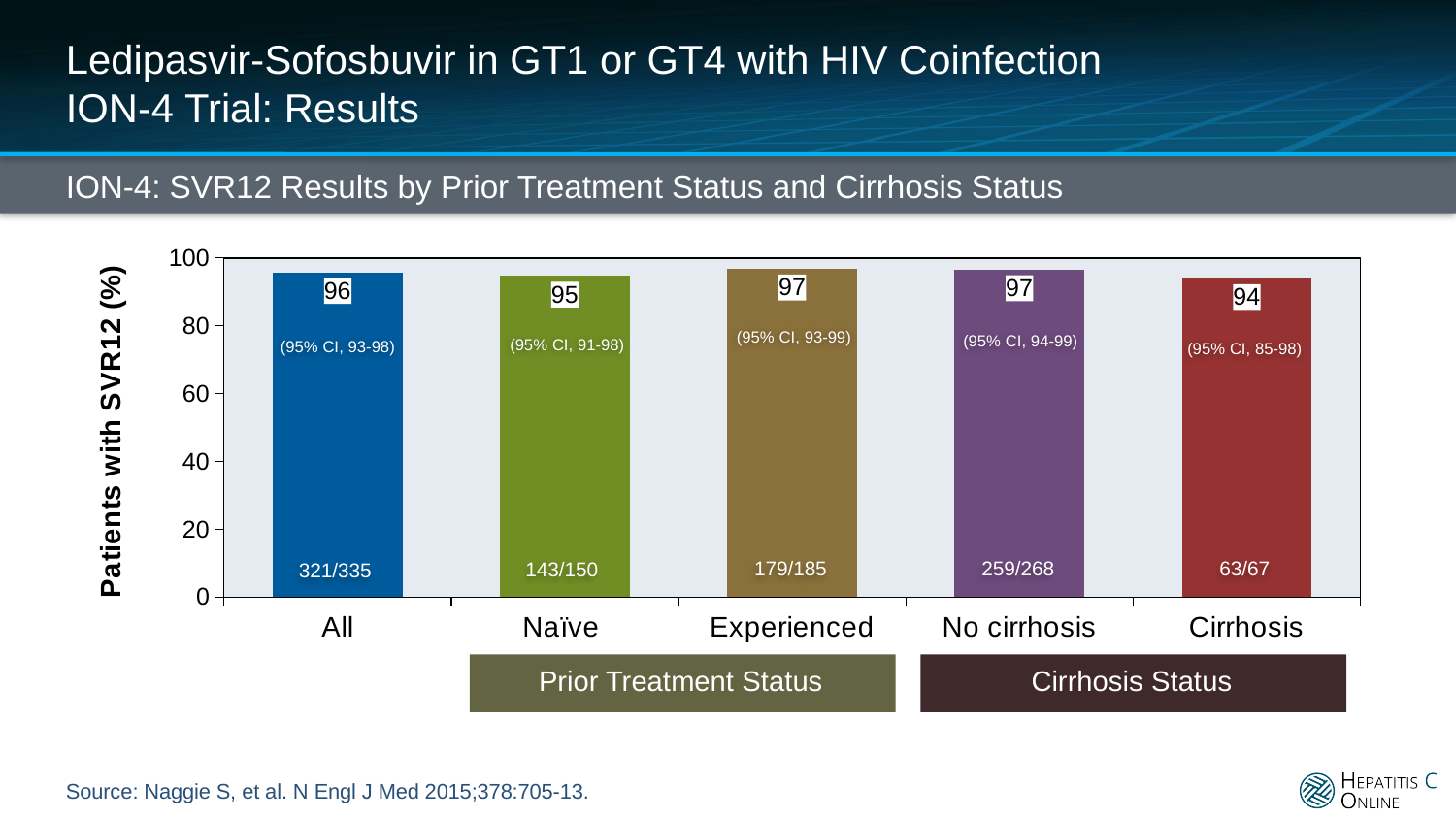
What is the y-axis label of the chart? Patients with SVR12 (%) What is the SVR12 rate for the All group? 96 What fraction of patients is shown for the Experienced group? 179/185 Which group has the lowest SVR12 rate? Cirrhosis How many groups are shown on the x axis? 5 What is the SVR12 rate for the Cirrhosis group? 94 What is the SVR12 rate for the Naïve group? 95 Which two groups fall under the Cirrhosis Status heading? No cirrhosis and Cirrhosis What kind of chart is shown? Bar chart What is the 95% CI shown for the No cirrhosis group? 94-99 What is the difference in SVR12 rate between the All group and the Cirrhosis group? 2 Which has a higher SVR12 rate, Naïve or Experienced? Experienced